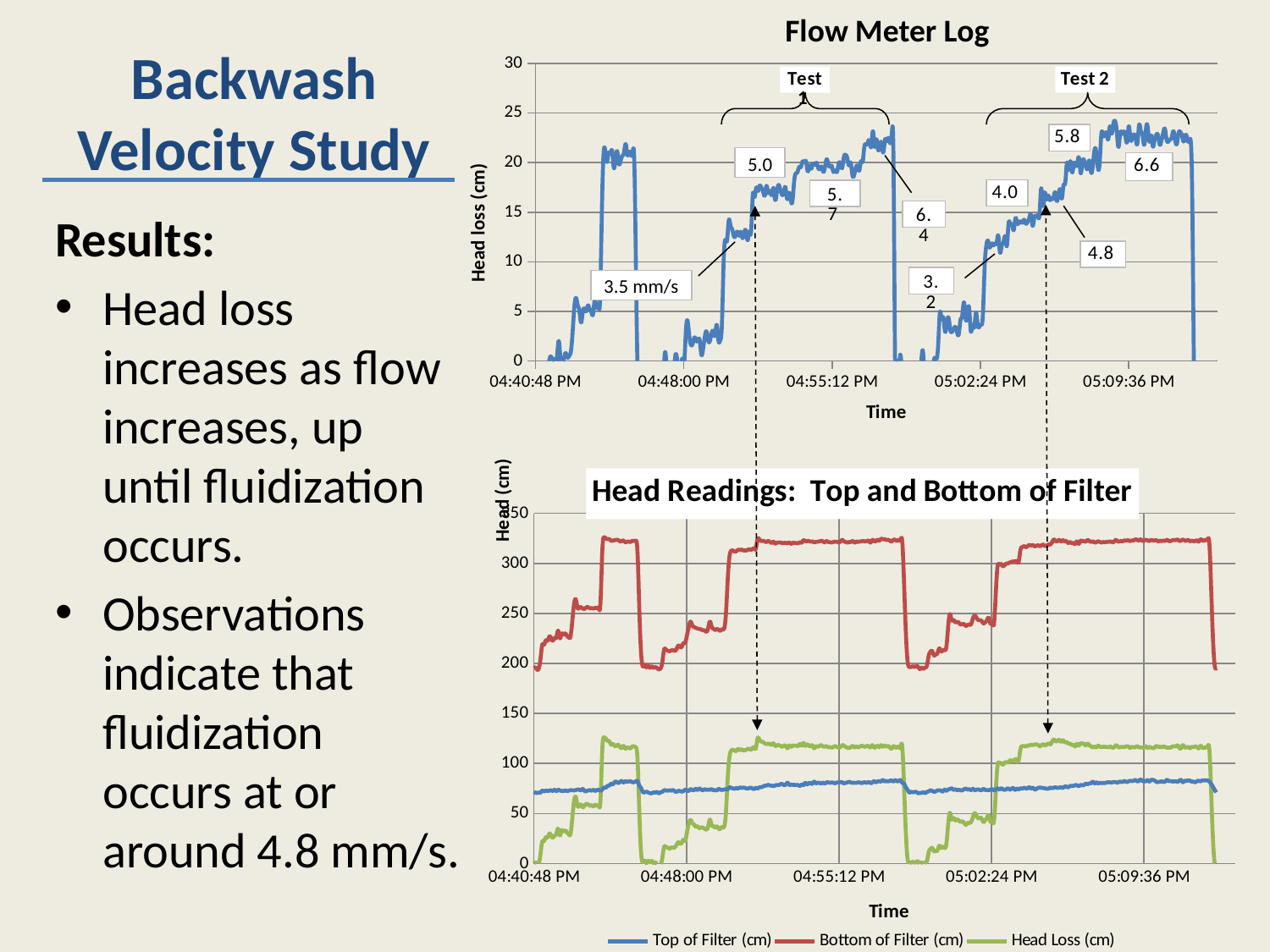
In the Head Readings: Top and Bottom of Filter chart, which series has the lowest value at 04:40:48 PM? Head Loss (cm) How many time tick labels are shown on the x axis of the Flow Meter Log chart? 5 What kind of chart is the Flow Meter Log chart? line chart In the Head Readings: Top and Bottom of Filter chart, is the Top of Filter (cm) series greater or less than 100 across the whole time range? less In the Head Readings: Top and Bottom of Filter chart, which series is larger at 05:09:36 PM, Top of Filter (cm) or Head Loss (cm)? Head Loss (cm) In the Flow Meter Log chart, is the maximum head loss reached greater or less than 20? greater In the Head Readings: Top and Bottom of Filter chart, is the highest value of the Bottom of Filter (cm) series greater or less than 300? greater What are the legend entries of the Head Readings: Top and Bottom of Filter chart? Top of Filter (cm), Bottom of Filter (cm), Head Loss (cm) What is the y-axis label of the Flow Meter Log chart? Head loss (cm) How many series does the legend of the Head Readings: Top and Bottom of Filter chart list? 3 In the Head Readings: Top and Bottom of Filter chart, which series has the highest values? Bottom of Filter (cm) What kind of chart is the Head Readings: Top and Bottom of Filter chart? line chart